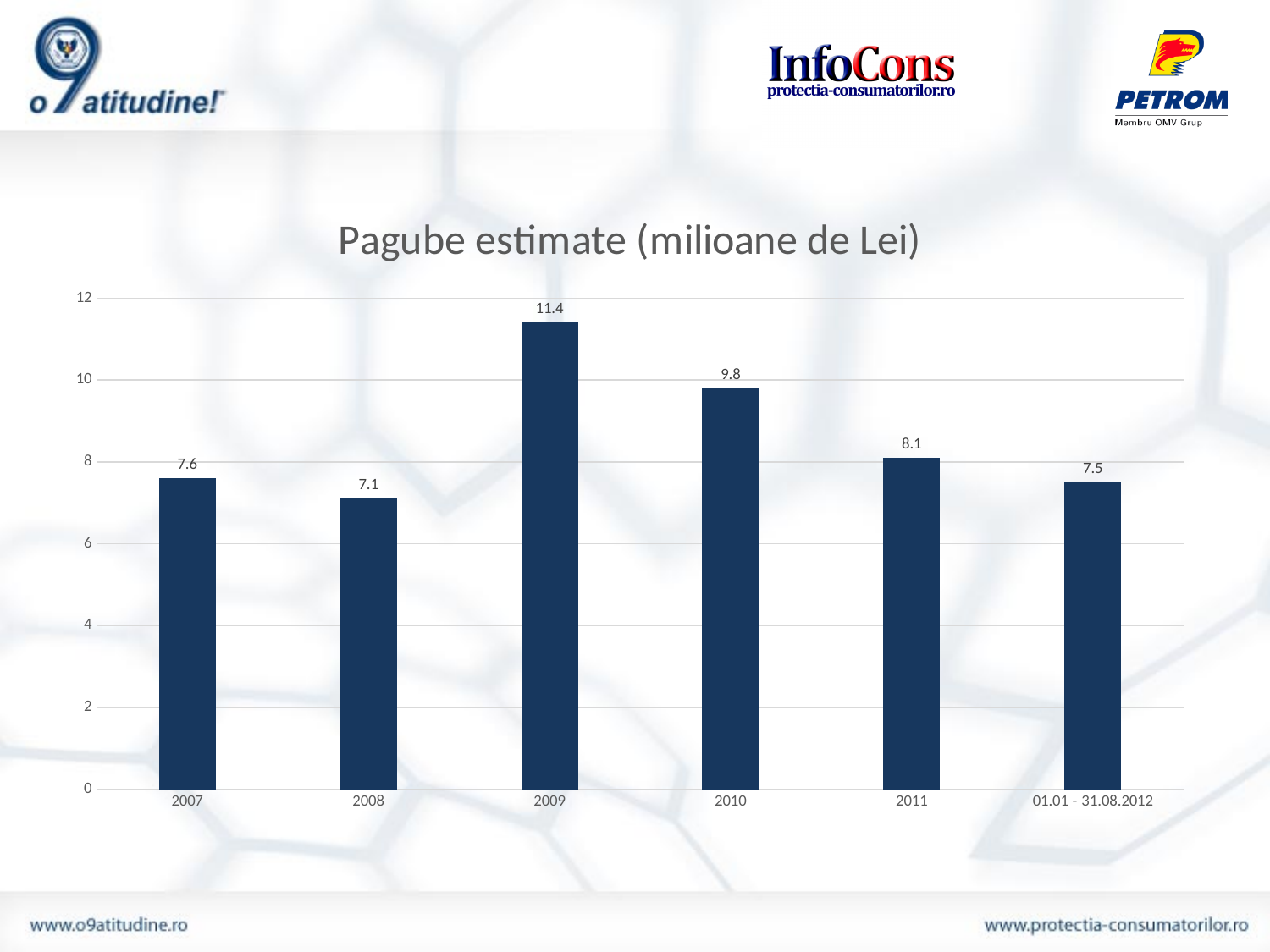
What is the value shown for 2011? 8.1 What is the difference between the values for 2009 and 2010? 1.6 What is the estimated damage value for 2009? 11.4 What is the title of the chart? Pagube estimate (milioane de Lei) How many bars are shown in the chart? 6 What kind of chart is shown on the slide? bar chart Which year has the highest estimated damage? 2009 Which category has the lowest value? 2008 What is the value shown for the period 01.01 - 31.08.2012? 7.5 Do the values rise or fall from 2009 to 01.01 - 31.08.2012? fall Which is larger, the value for 2007 or the value for 2008? 2007 Is the value for 2010 greater or less than 10? less